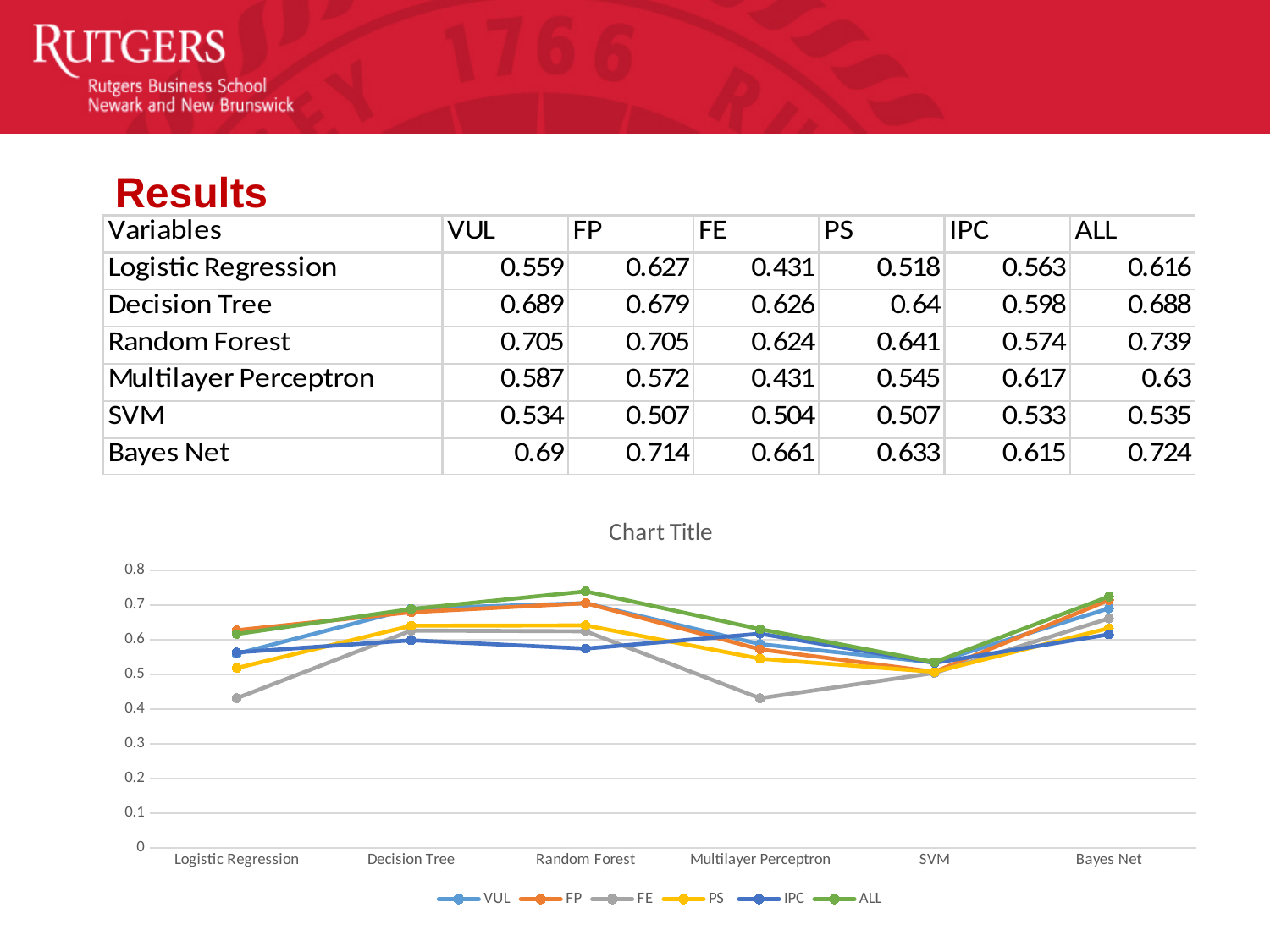
What is the value of the ALL series for Random Forest? 0.739 What is the value of the FE series for Bayes Net? 0.661 For which category is the VUL series lowest? SVM Which is larger, the FP value for Bayes Net or the FP value for Random Forest? Bayes Net What is the title shown above the chart? Chart Title How many series does the chart legend list? 6 What kind of chart is shown on the slide? line chart Does the ALL series rise or fall from Multilayer Perceptron to SVM? fall How many categories are plotted along the x axis of the chart? 6 For which category is the ALL series highest? Random Forest What is the difference between the ALL value for Random Forest and the ALL value for SVM? 0.204 Is the FE value for Multilayer Perceptron greater or less than 0.5? less